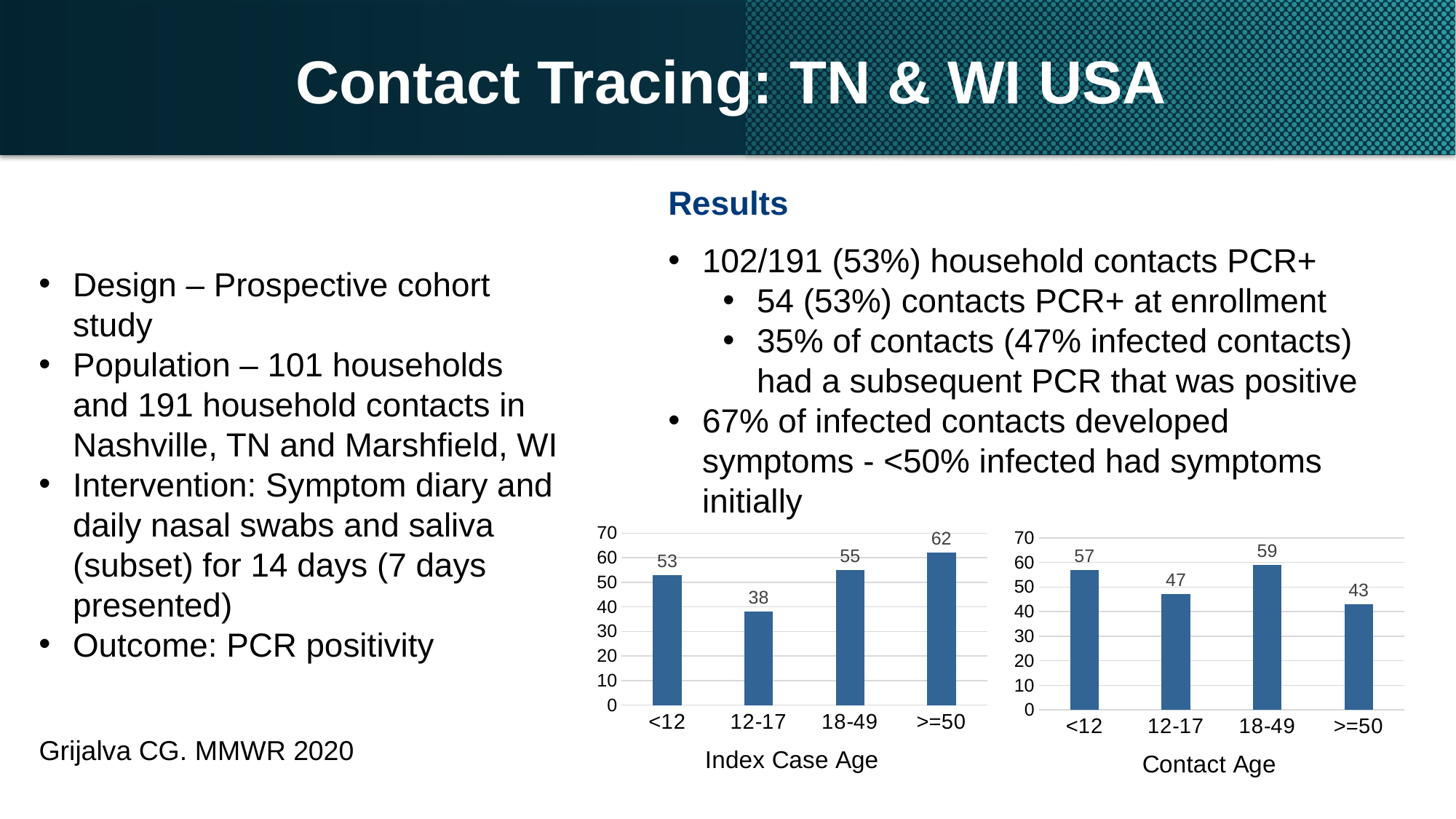
In the Contact Age chart, what is the value for the >=50 category? 43 In the Index Case Age chart, what is the value for the <12 category? 53 In the Index Case Age chart, which category has the lowest value? 12-17 In the Index Case Age chart, what is the difference between the values for >=50 and <12? 9 In the Contact Age chart, which category has the lowest value? >=50 In the Index Case Age chart, what is the value for the 12-17 category? 38 How many categories are shown in the Index Case Age chart? 4 In the Contact Age chart, which is larger, the value for <12 or the value for 12-17? <12 What kind of chart is the Contact Age chart? Bar chart In the Contact Age chart, what is the difference between the values for 18-49 and 12-17? 12 In the Index Case Age chart, which category has the highest value? >=50 In the Contact Age chart, what is the value for the 18-49 category? 59